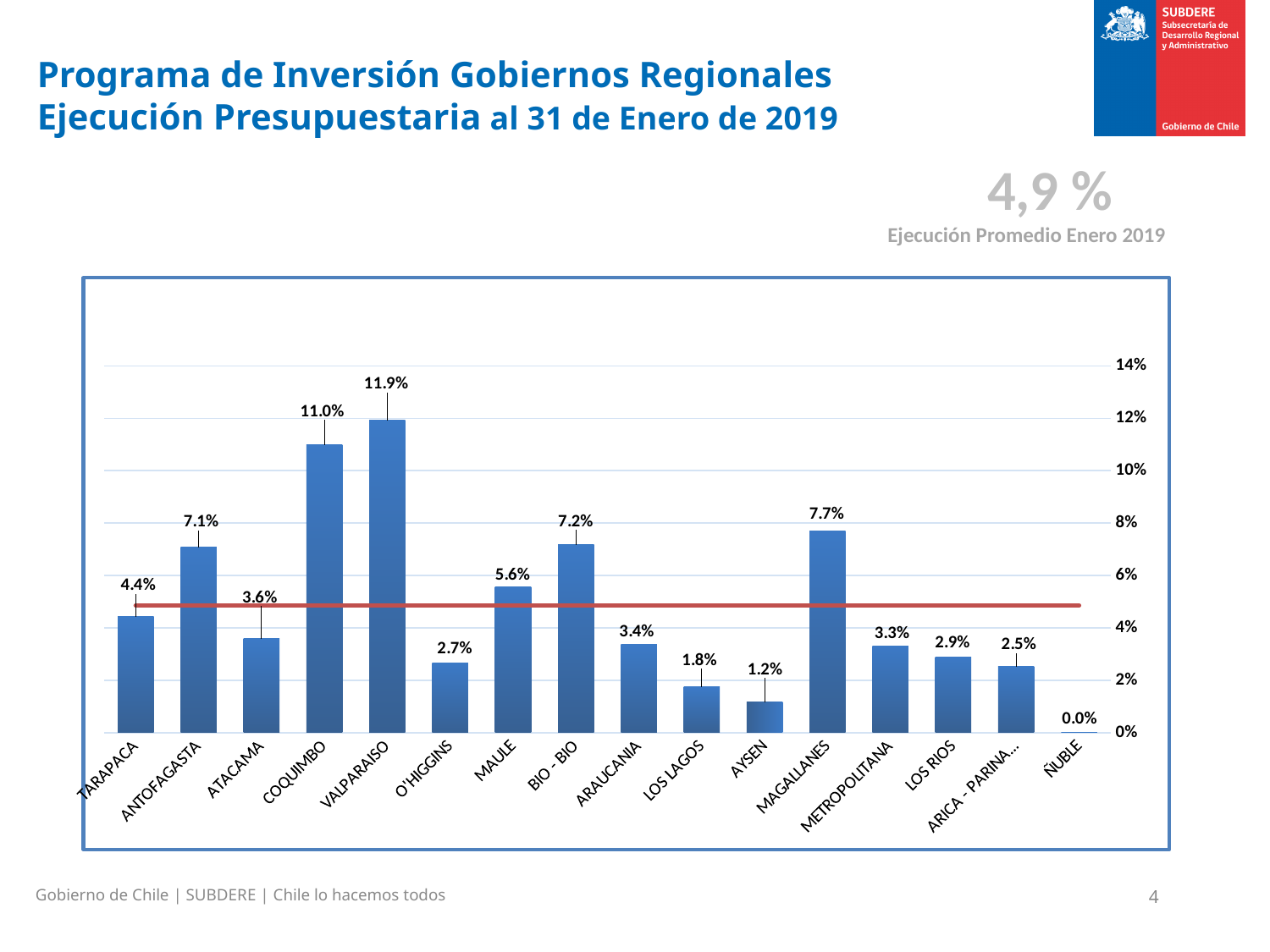
What is the difference between the values for VALPARAISO and COQUIMBO? 0.9% What is the value for VALPARAISO? 11.9% Is the value for COQUIMBO greater or less than 10%? greater Which region has the lowest value? ÑUBLE Which region has the highest value? VALPARAISO Which is larger, the value for MAULE or the value for TARAPACA? MAULE What average value is shown above the chart for Ejecución Promedio Enero 2019? 4,9 % How many regions are shown on the x axis? 16 What is the difference between the values for ANTOFAGASTA and ATACAMA? 3.5% What is the value for AYSEN? 1.2% What is the value for MAGALLANES? 7.7% What kind of chart is shown on the slide? bar chart